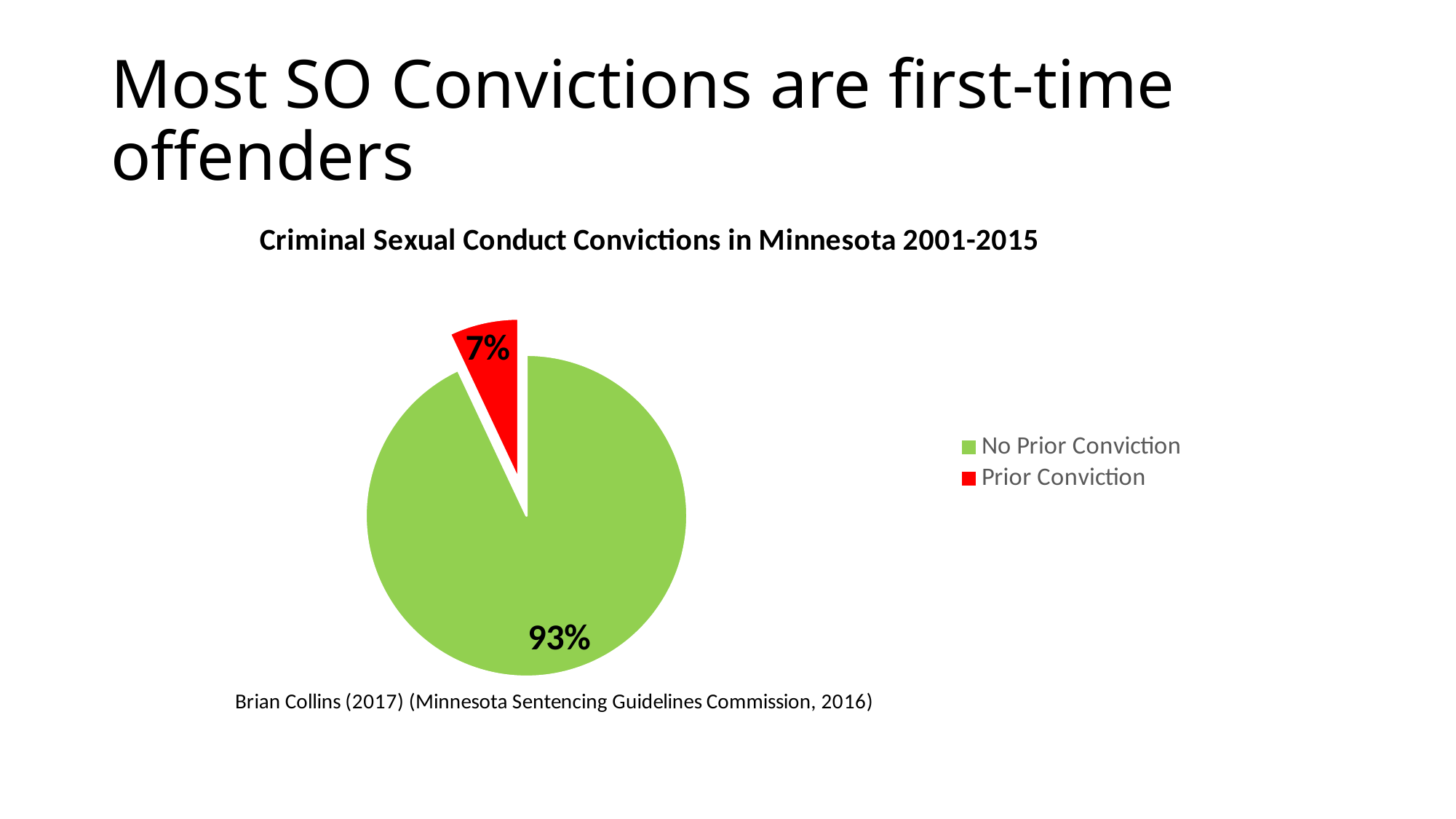
What is the title of the chart? Criminal Sexual Conduct Convictions in Minnesota 2001-2015 Which category has the smallest slice of the pie? Prior Conviction How many entries does the legend list? 2 What is the difference in percentage points between the No Prior Conviction and Prior Conviction slices? 86 What share of the pie is labelled No Prior Conviction? 93% What colour is the Prior Conviction slice? Red Which slice is larger, No Prior Conviction or Prior Conviction? No Prior Conviction Which category has the largest slice of the pie? No Prior Conviction What share of the pie is labelled Prior Conviction? 7% What kind of chart is shown on the slide? Pie chart How many slices does the pie chart have? 2